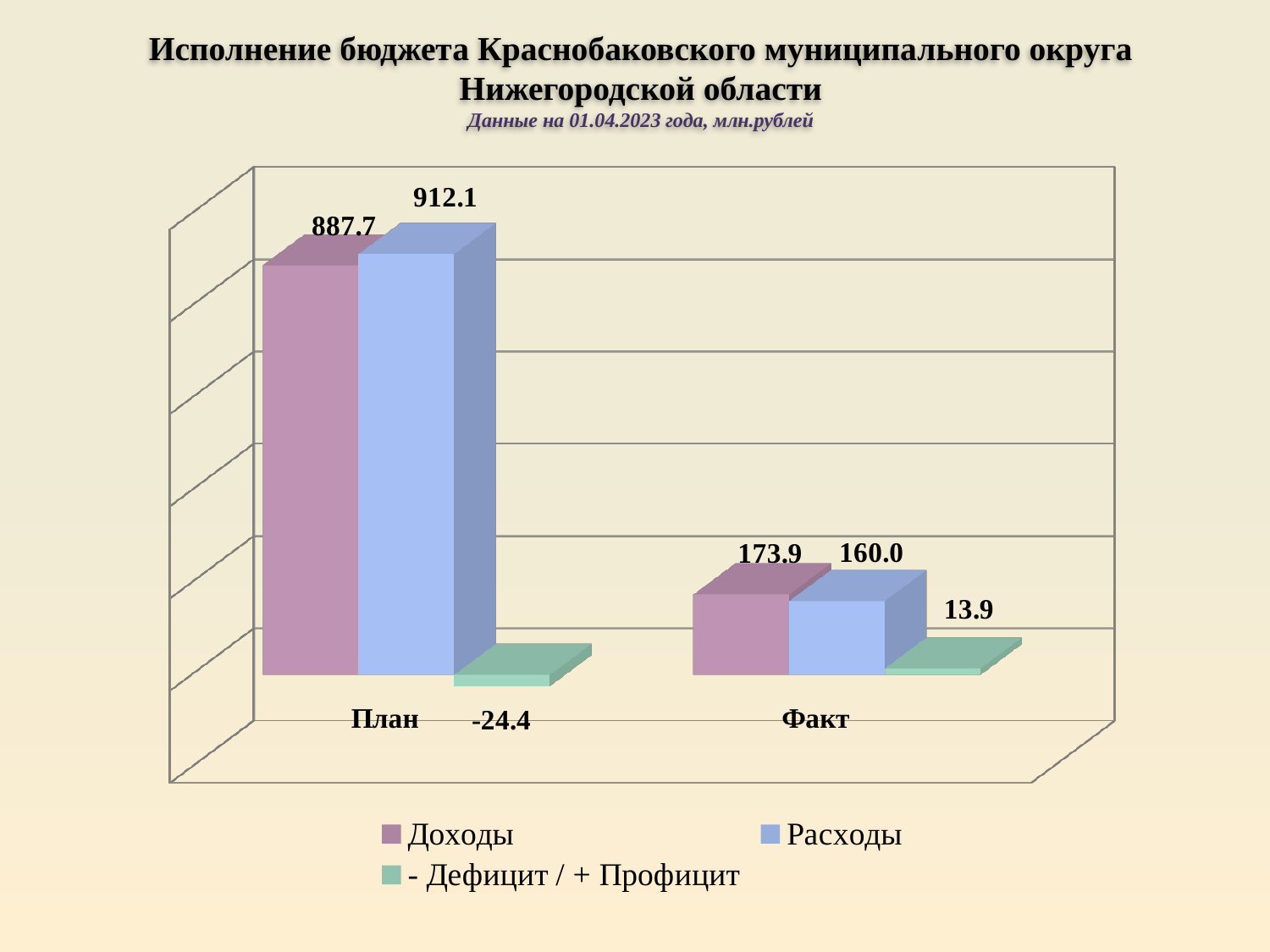
What is the value of Расходы for План? 912.1 What is the value of Расходы for Факт? 160.0 How many categories are shown on the x axis? 2 What is the value of - Дефицит / + Профицит for Факт? 13.9 What kind of chart is shown on the slide? Bar chart Which is larger for План: Доходы or Расходы? Расходы What is the value of - Дефицит / + Профицит for План? -24.4 What is the value of Доходы for Факт? 173.9 How many series does the legend list? 3 Which is larger for Факт: Доходы or Расходы? Доходы What is the difference between Расходы and Доходы for План? 24.4 What is the value of Доходы for План? 887.7